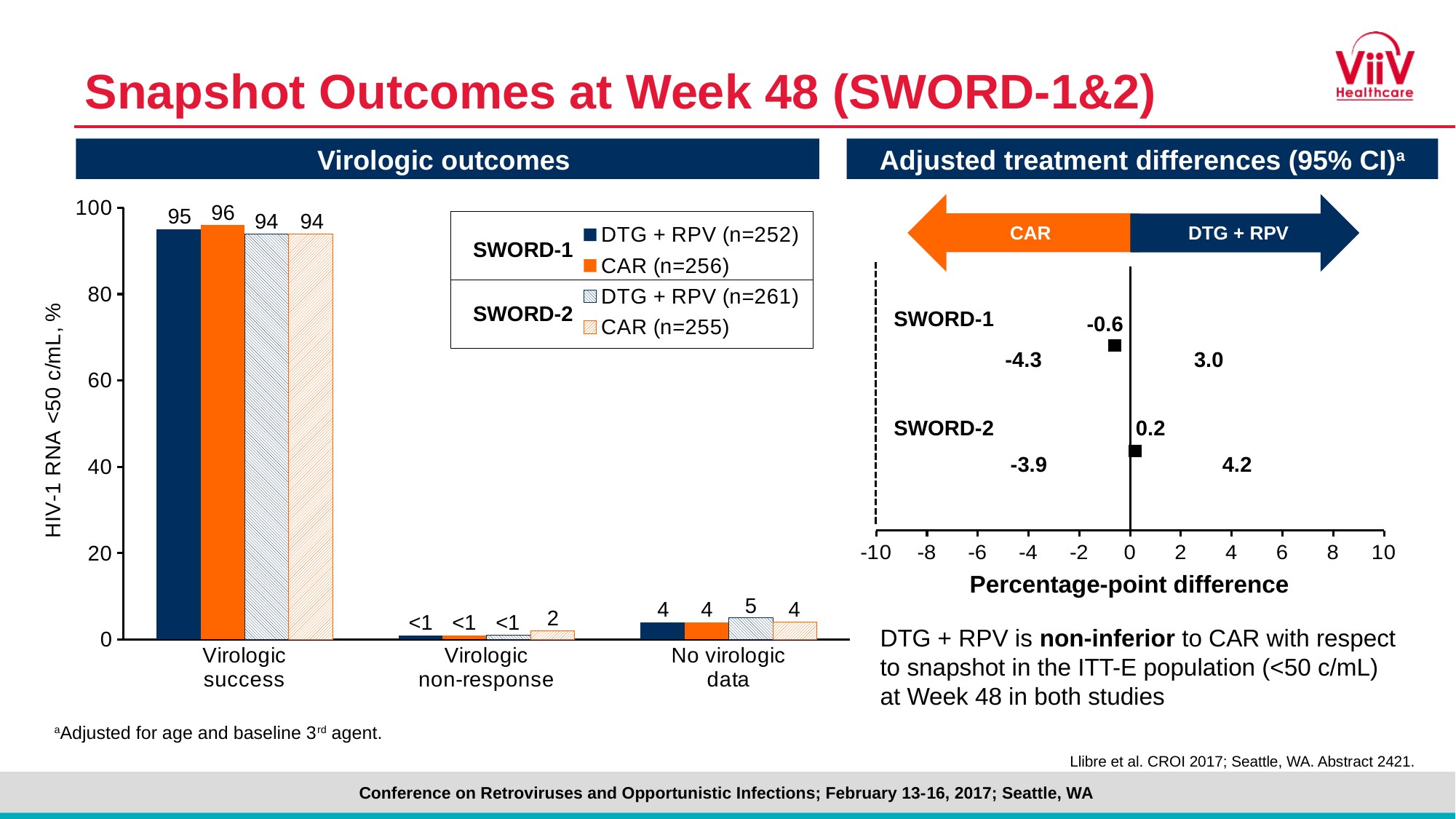
In the Virologic outcomes chart, what is the virologic success value for SWORD-1 CAR (n=256)? 96 How many series does the legend of the Virologic outcomes chart list? 4 In the Virologic outcomes chart, what is the difference in virologic success between SWORD-1 CAR (n=256) and SWORD-1 DTG + RPV (n=252)? 1 What is the x-axis label of the Adjusted treatment differences chart? Percentage-point difference What kind of chart is the Virologic outcomes chart? Bar chart In the Adjusted treatment differences chart, what is the upper bound of the 95% CI for SWORD-2? 4.2 In the Virologic outcomes chart, which series has the highest virologic success value? SWORD-1 CAR (n=256) How many outcome categories are shown on the x axis of the Virologic outcomes chart? 3 In the Virologic outcomes chart, what is the value for SWORD-2 CAR (n=255) in the Virologic non-response category? 2 In the Adjusted treatment differences chart, what is the point estimate for SWORD-1? -0.6 In the Virologic outcomes chart, what is the value for SWORD-2 DTG + RPV (n=261) in the No virologic data category? 5 In the Adjusted treatment differences chart, what is the lower bound of the 95% CI for SWORD-1? -4.3